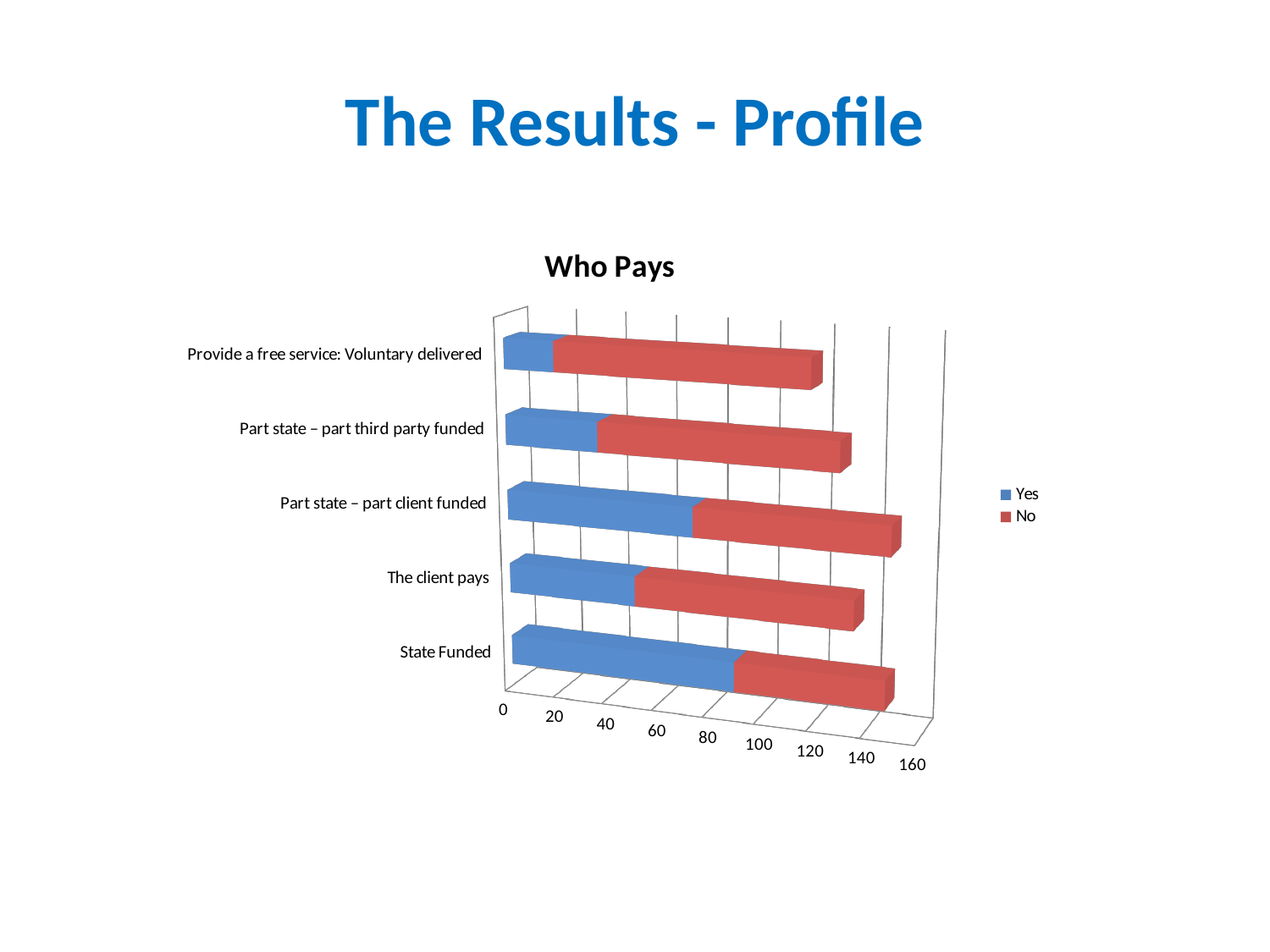
How many series does the legend of the Who Pays chart list? 2 Is the Yes value for Provide a free service: Voluntary delivered greater or less than 60? less Which has the larger No value: Provide a free service: Voluntary delivered or The client pays? Provide a free service: Voluntary delivered Which category has the largest Yes value in the Who Pays chart? State Funded Is the Yes value for Part state – part client funded greater or less than 40? greater Which series is shown in blue in the Who Pays chart? Yes Is the Yes value for State Funded greater or less than 60? greater Which category has the smallest Yes value in the Who Pays chart? Provide a free service: Voluntary delivered Which has the larger Yes value: State Funded or Provide a free service: Voluntary delivered? State Funded How many categories are shown in the Who Pays chart? 5 What kind of chart is shown on the slide? bar chart What is the title of the chart? Who Pays